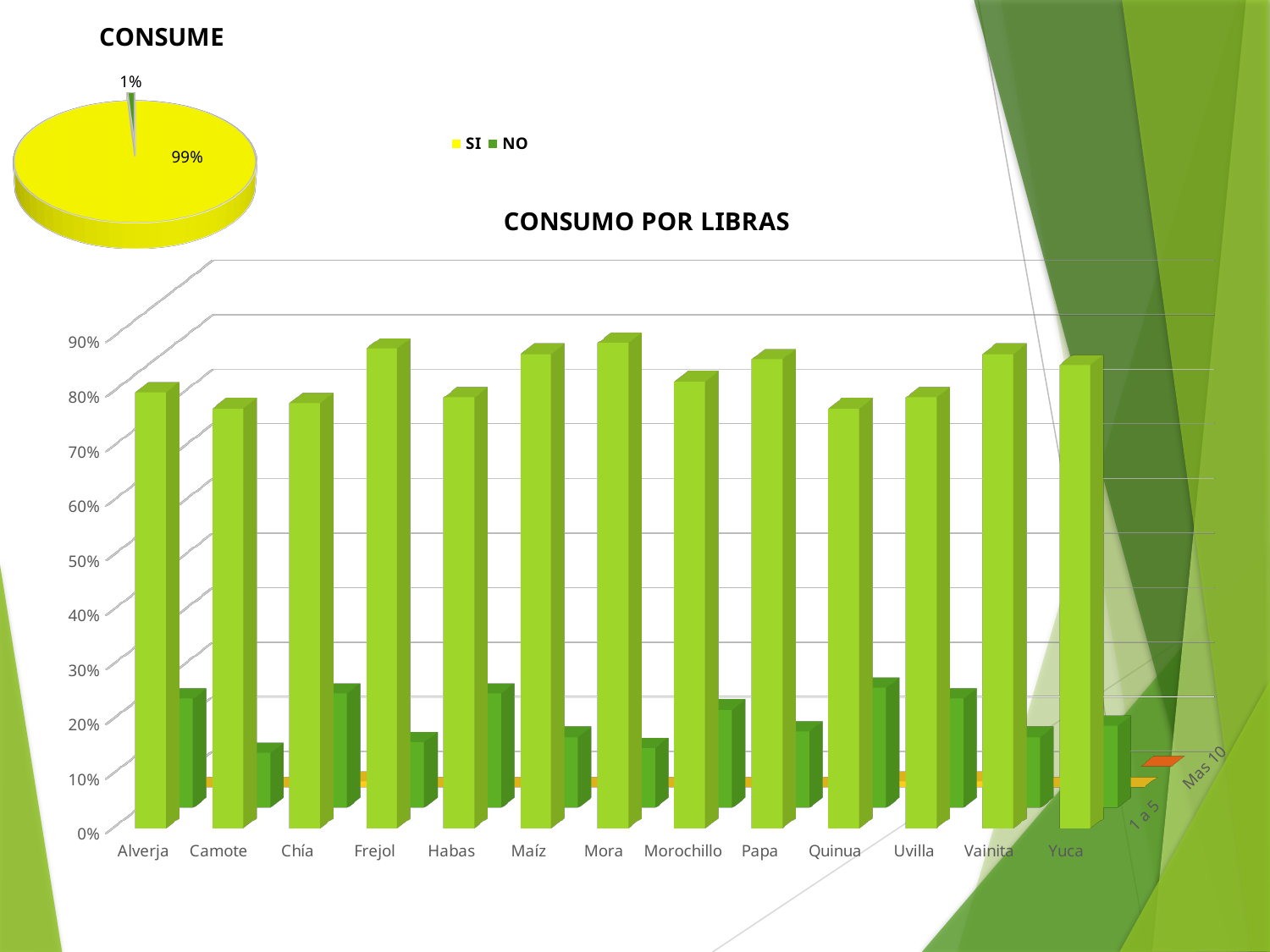
On the CONSUMO POR LIBRAS chart, how many categories are shown on the x axis? 13 On the CONSUME pie chart, what percentage is shown for SI? 99% What kind of chart is the CONSUME chart? Pie chart On the CONSUME pie chart, which slice is the smallest? NO On the CONSUMO POR LIBRAS chart, is the light green bar for Frejol greater or less than 50%? greater On the CONSUME pie chart, which slice is the largest? SI On the CONSUME pie chart, how many entries does the legend list? 2 On the CONSUMO POR LIBRAS chart, is the dark green bar for Camote greater or less than 50%? less On the CONSUME pie chart, what is the difference in percentage points between SI and NO? 98 On the CONSUME pie chart, what percentage is shown for NO? 1% On the CONSUMO POR LIBRAS chart, which light green bar is taller, Frejol or Camote? Frejol What kind of chart is the CONSUMO POR LIBRAS chart? Bar chart